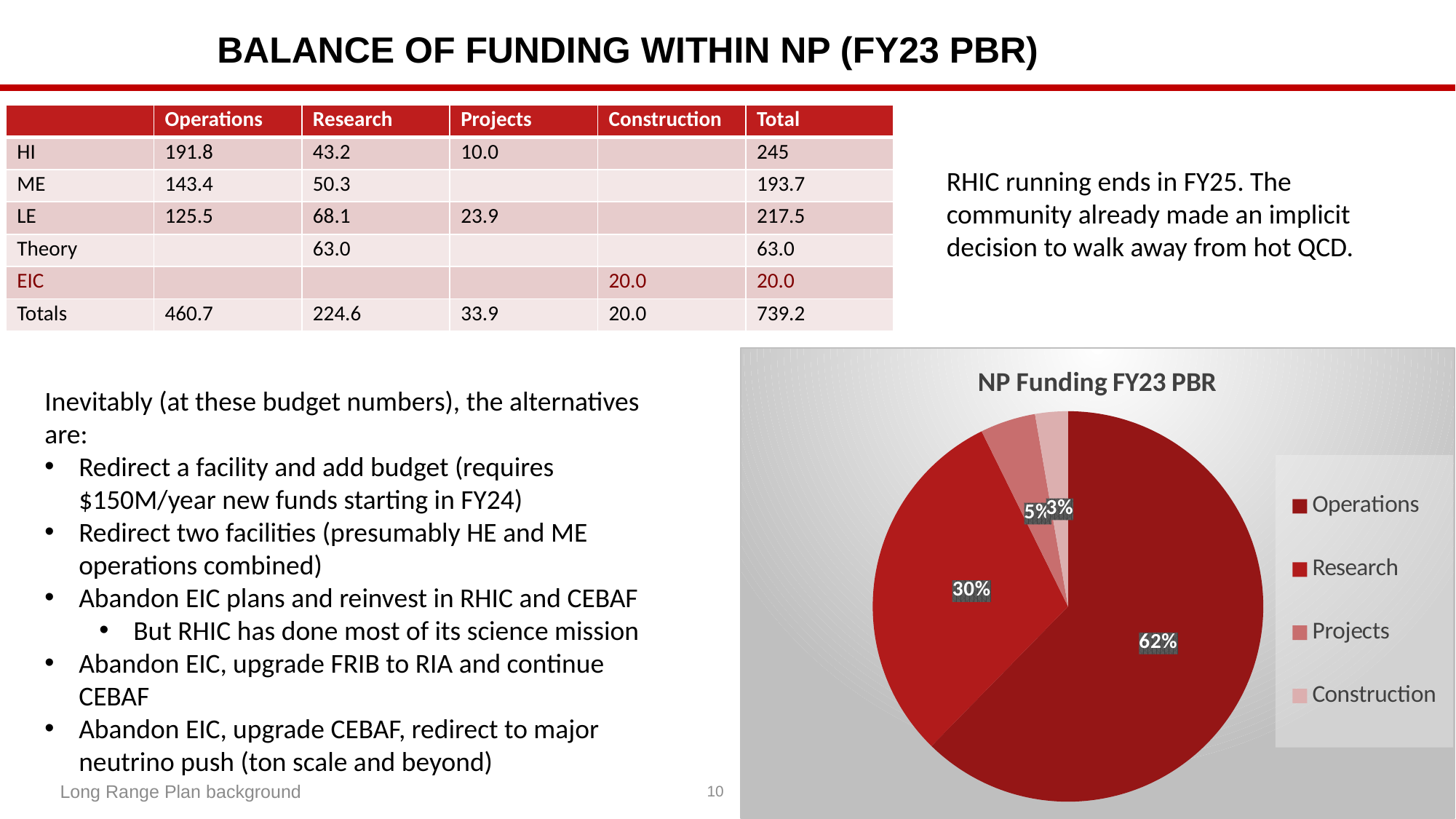
How many slices does the pie chart have? 4 What share of the pie does Operations have? 62% What is the title of the pie chart? NP Funding FY23 PBR How many entries does the pie chart's legend list? 4 What share of the pie does Construction have? 3% Which category has the smallest slice of the pie? Construction What kind of chart is shown on the slide? pie chart What share of the pie does Projects have? 5% What is the difference in percentage points between the Operations and Research slices? 32 Which slice is larger, Research or Projects? Research Which category has the largest slice of the pie? Operations